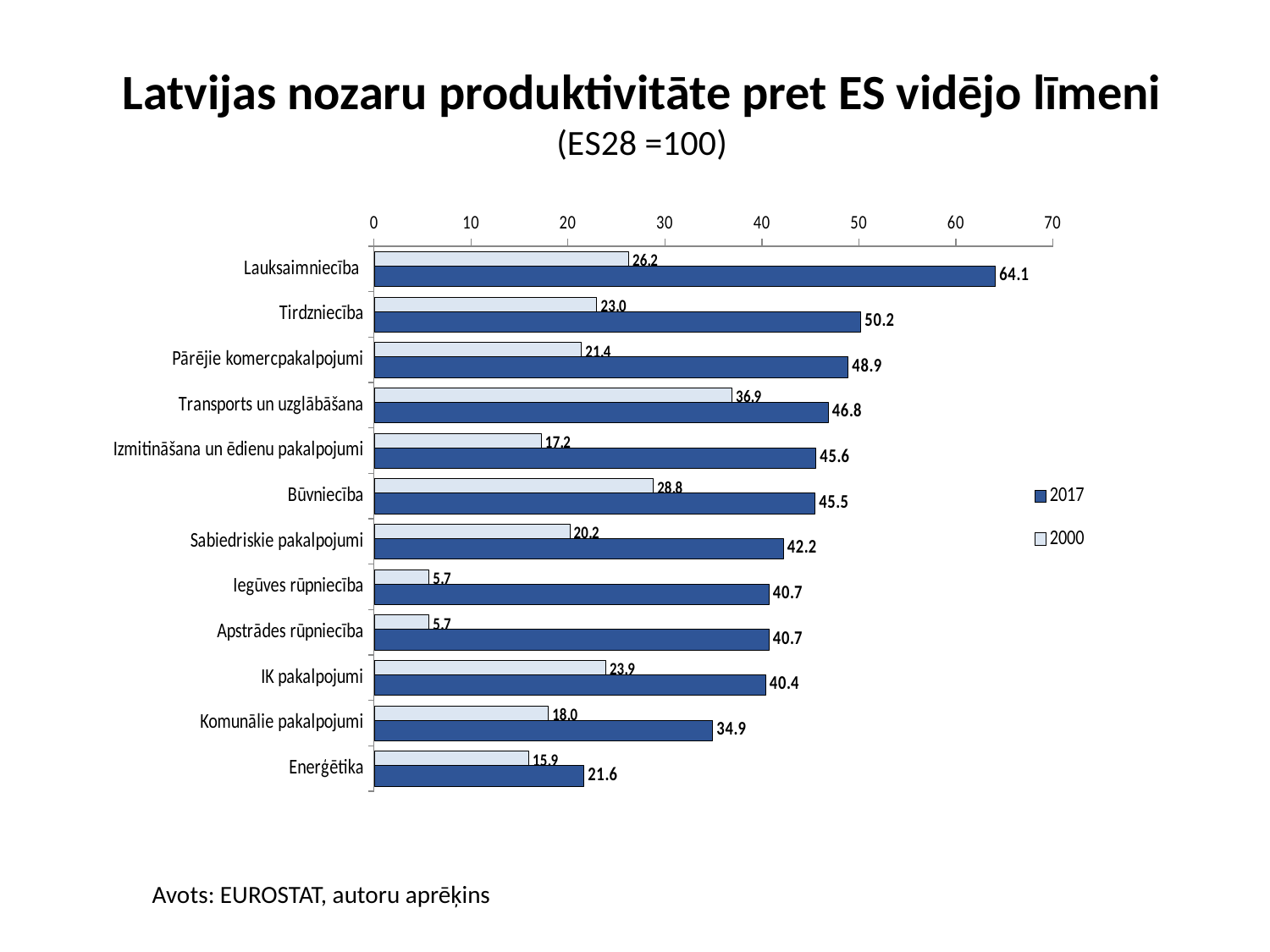
What is the source cited below the chart? EUROSTAT, autoru aprēķins What is the difference between the 2017 and 2000 values for Lauksaimniecība? 37.9 Which category has the lowest 2017 value? Enerģētika What is the 2000 value for Transports un uzglābāšana? 36.9 Which category has the highest 2000 value? Transports un uzglābāšana What is the 2017 value for Enerģētika? 21.6 How many categories are shown on the chart? 12 What is the 2017 value for Lauksaimniecība? 64.1 What kind of chart is shown on the slide? Bar chart Which category has the highest 2017 value? Lauksaimniecība How many series does the legend list? 2 Which is larger: the 2000 value for Būvniecība or the 2000 value for IK pakalpojumi? Būvniecība